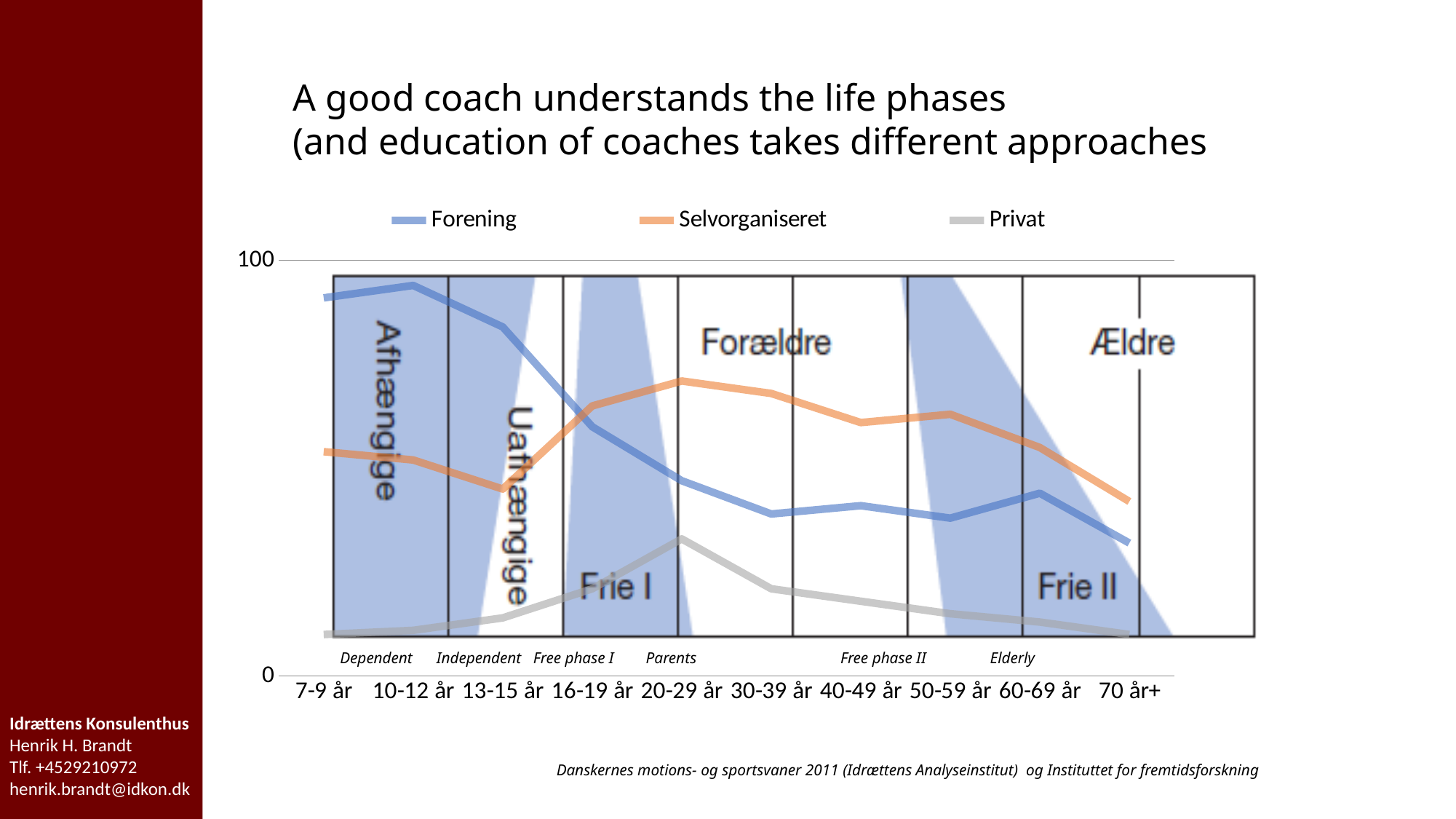
For the 7-9 år group, which is larger: Forening or Selvorganiseret? Forening What kind of chart is shown on the slide? line chart Which colour represents the Privat series in the legend? grey In which age group does the Forening series reach its lowest value? 70 år+ In which age group does the Selvorganiseret series reach its highest value? 20-29 år What is the highest value shown on the y axis? 100 Does the Forening series generally rise or fall from 10-12 år to 70 år+? fall In which age group does the Forening series reach its highest value? 10-12 år How many series does the legend list? 3 How many age groups are shown along the x axis? 10 For the 70 år+ group, which is larger: Forening or Selvorganiseret? Selvorganiseret In which age group does the Privat series reach its highest value? 20-29 år